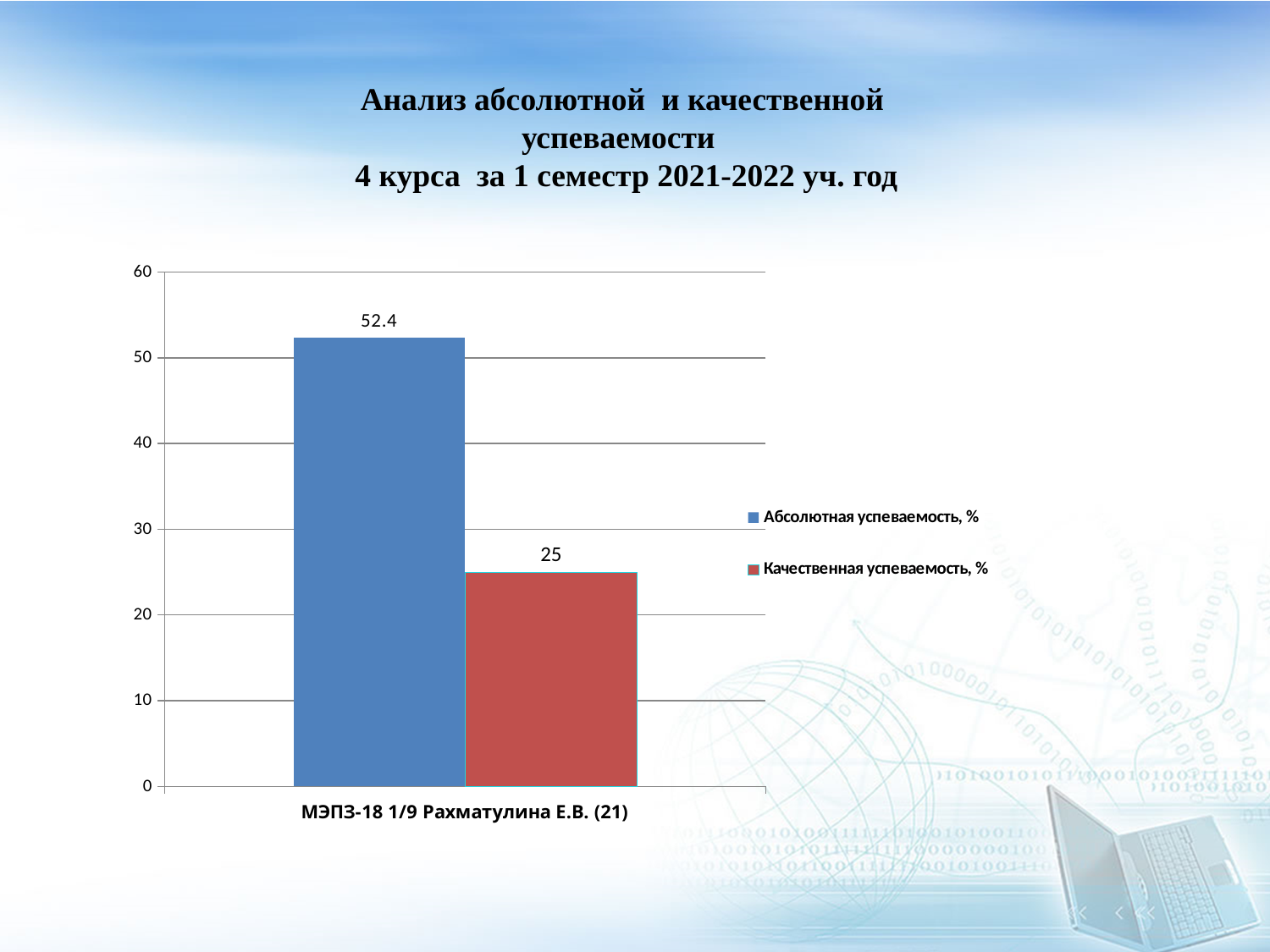
What is the value of Качественная успеваемость, % for МЭПЗ-18 1/9 Рахматулина Е.В. (21)? 25 How many series does the legend list? 2 What is the maximum value shown on the vertical axis? 60 Which series has the higher value for МЭПЗ-18 1/9 Рахматулина Е.В. (21)? Абсолютная успеваемость, % Is the value for Качественная успеваемость, % greater or less than 30? less What kind of chart is shown on the slide? Bar chart Is the value for Абсолютная успеваемость, % greater or less than 50? greater What is the value of Абсолютная успеваемость, % for МЭПЗ-18 1/9 Рахматулина Е.В. (21)? 52.4 How many categories are shown on the x axis? 1 What colour is the bar for Качественная успеваемость, %? Red What is the difference between Абсолютная успеваемость, % and Качественная успеваемость, % for МЭПЗ-18 1/9 Рахматулина Е.В. (21)? 27.4 What is the label of the category on the x axis? МЭПЗ-18 1/9 Рахматулина Е.В. (21)